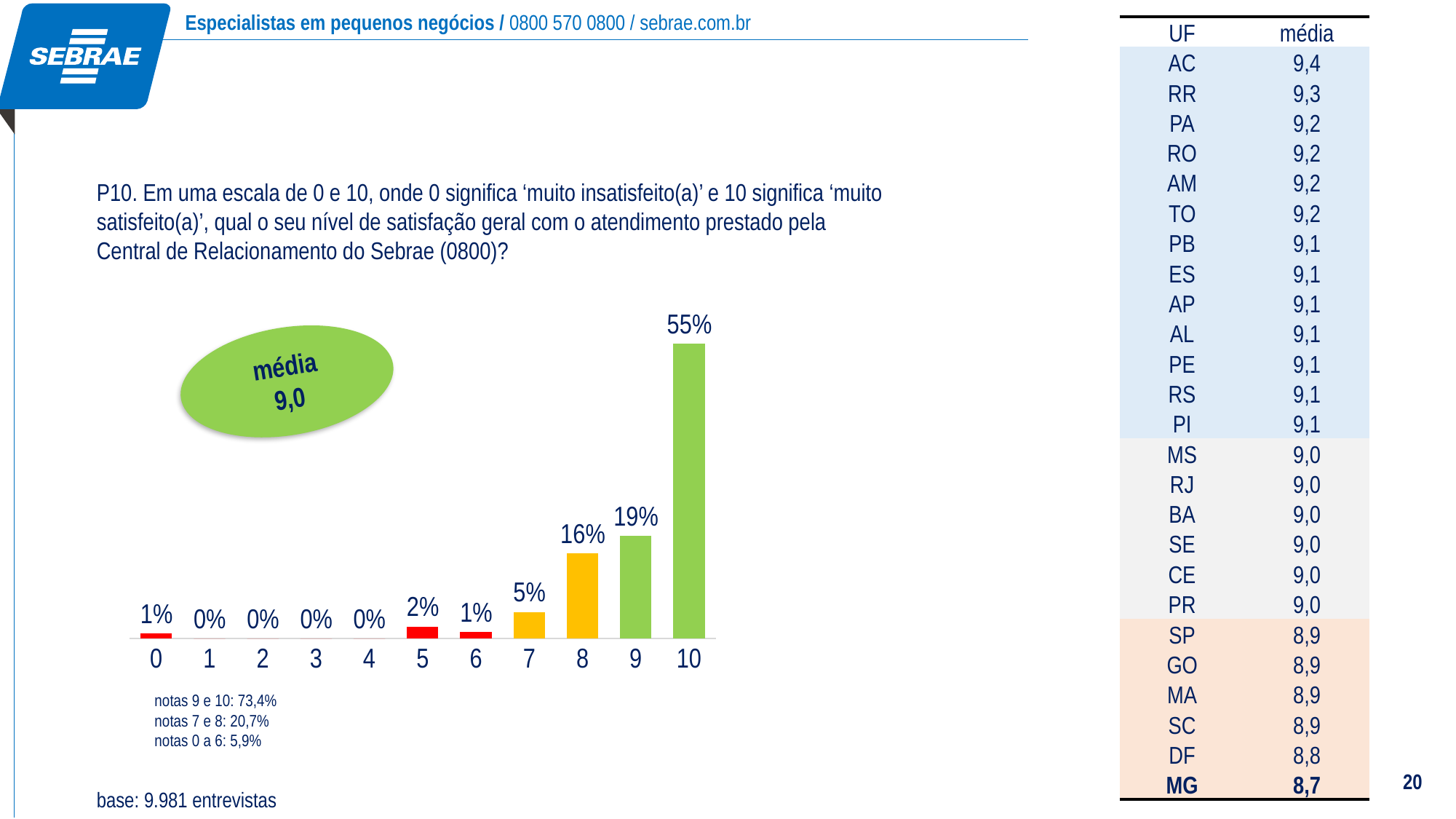
What percentage of respondents gave a score of 8? 16% What is the difference in percentage points between the bars for score 10 and score 9? 36% Which has a larger percentage, score 7 or score 6? 7 What is the combined percentage of the bars for scores 9 and 10? 74% What is the difference in percentage points between the bars for score 9 and score 8? 3% What percentage of respondents gave a score of 10? 55% Do the bar values generally rise or fall from score 5 to score 10? rise How many score categories are shown on the x axis of the bar chart? 11 What percentage of respondents gave a score of 5? 2% Which score has the highest percentage of respondents? 10 What type of chart is used to show the distribution of satisfaction scores? bar chart What percentage of respondents gave a score of 7? 5%